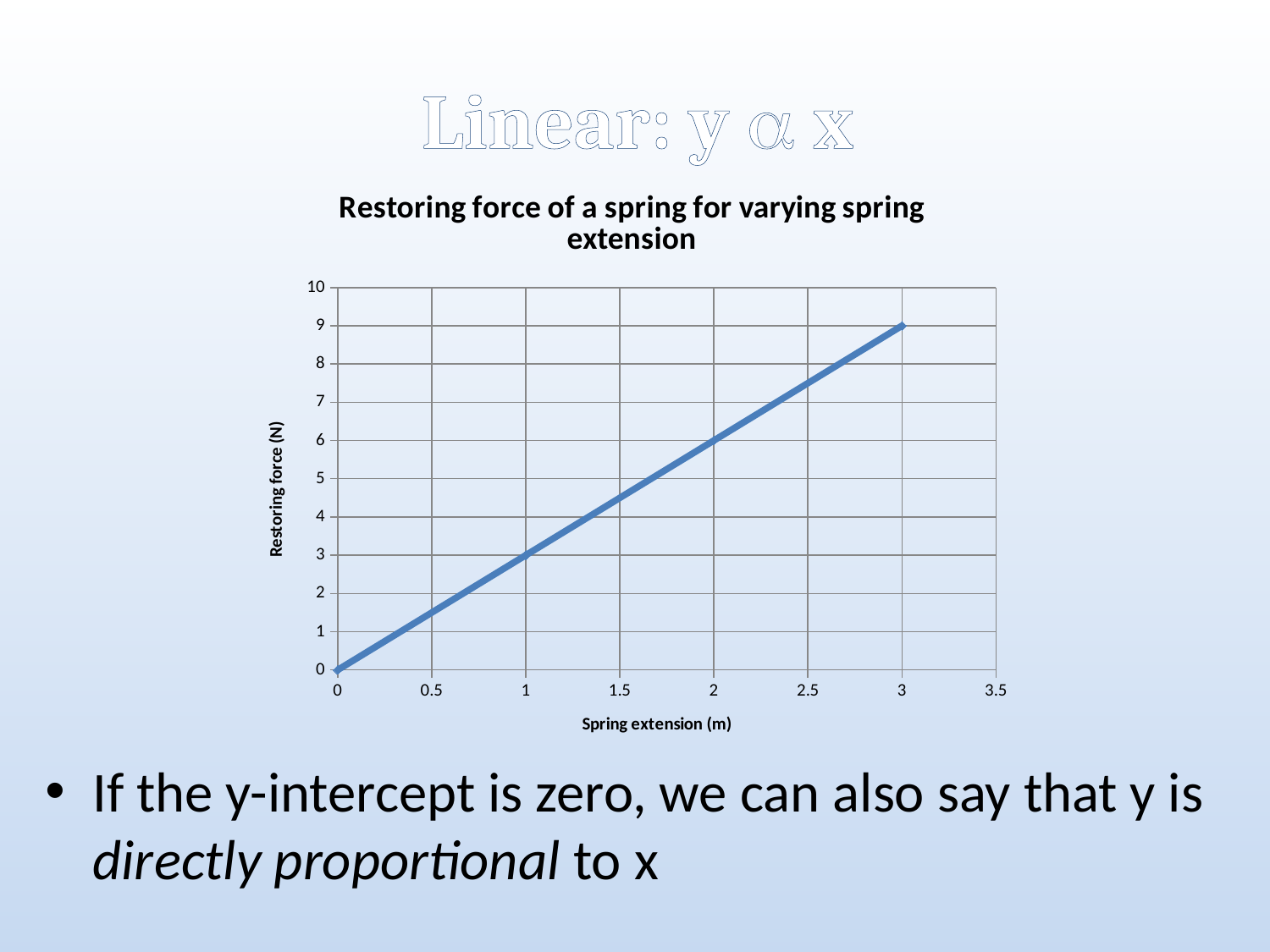
What is the title of the chart? Restoring force of a spring for varying spring extension What is the label of the y axis? Restoring force (N) What is the restoring force when the spring extension is 3 m? 9 Which spring extension gives the larger restoring force, 1 m or 2 m? 2 m What is the restoring force when the spring extension is 1 m? 3 What kind of chart is shown on the slide? line chart What is the difference in restoring force between a spring extension of 3 m and 1 m? 6 What is the restoring force when the spring extension is 2 m? 6 Is the restoring force at a spring extension of 0.5 m greater or less than 2? less What is the restoring force when the spring extension is 0 m? 0 Is the restoring force at a spring extension of 2.5 m greater or less than 7? greater Does the restoring force rise or fall as spring extension increases? rise